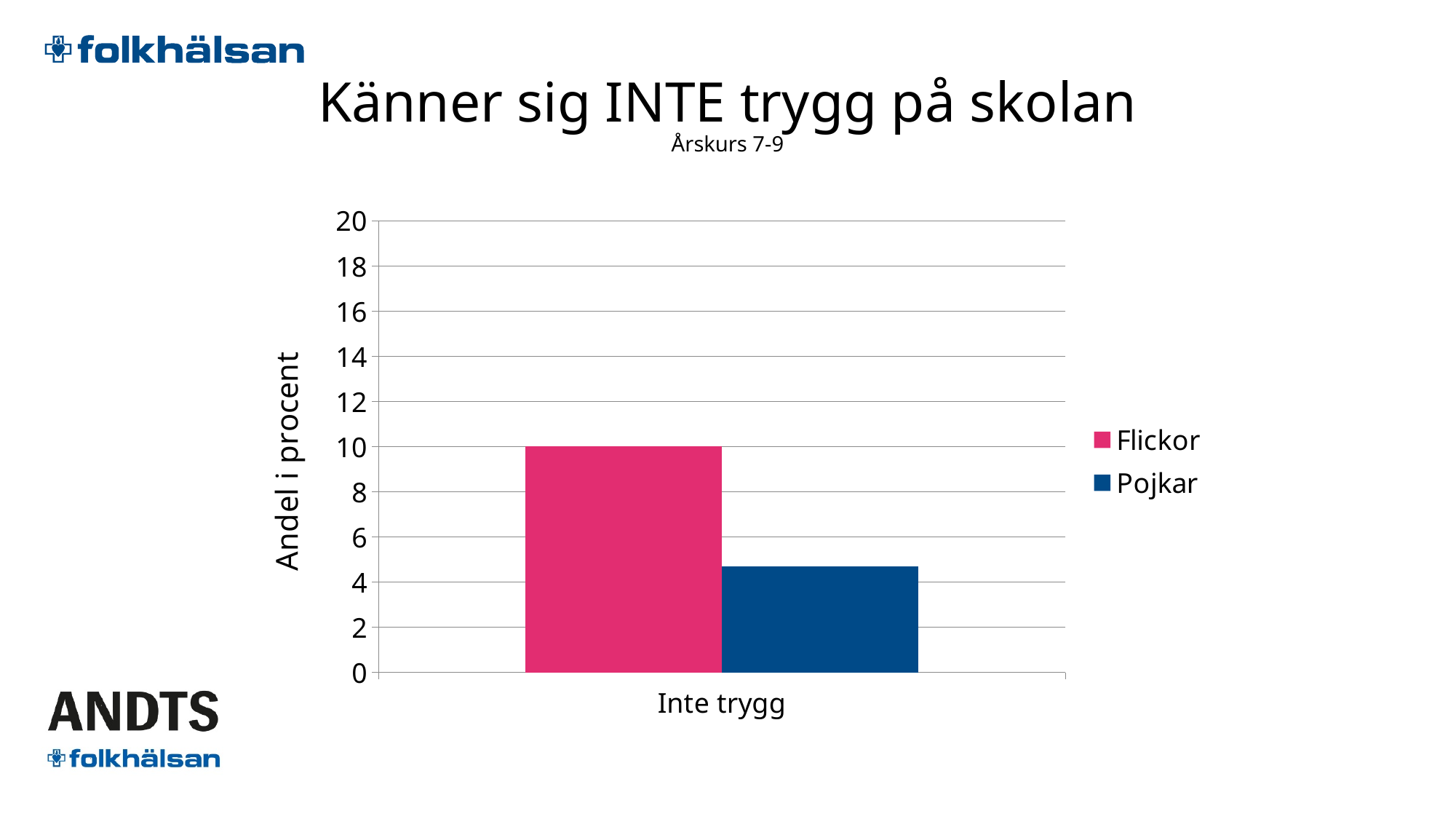
How many series does the legend list? 2 What kind of chart is shown on the slide? bar chart What is the label of the y axis? Andel i procent What is the label of the category on the x axis? Inte trygg Which series has the higher value for Inte trygg, Flickor or Pojkar? Flickor Is the value for Pojkar greater or less than 4? greater Is the value for Pojkar greater or less than 6? less Which series has the highest bar in the chart? Flickor What is the value for Flickor in the Inte trygg category? 10 Is the value for Flickor greater or less than 8? greater How many categories are shown on the x axis? 1 Which series has the lowest bar in the chart? Pojkar